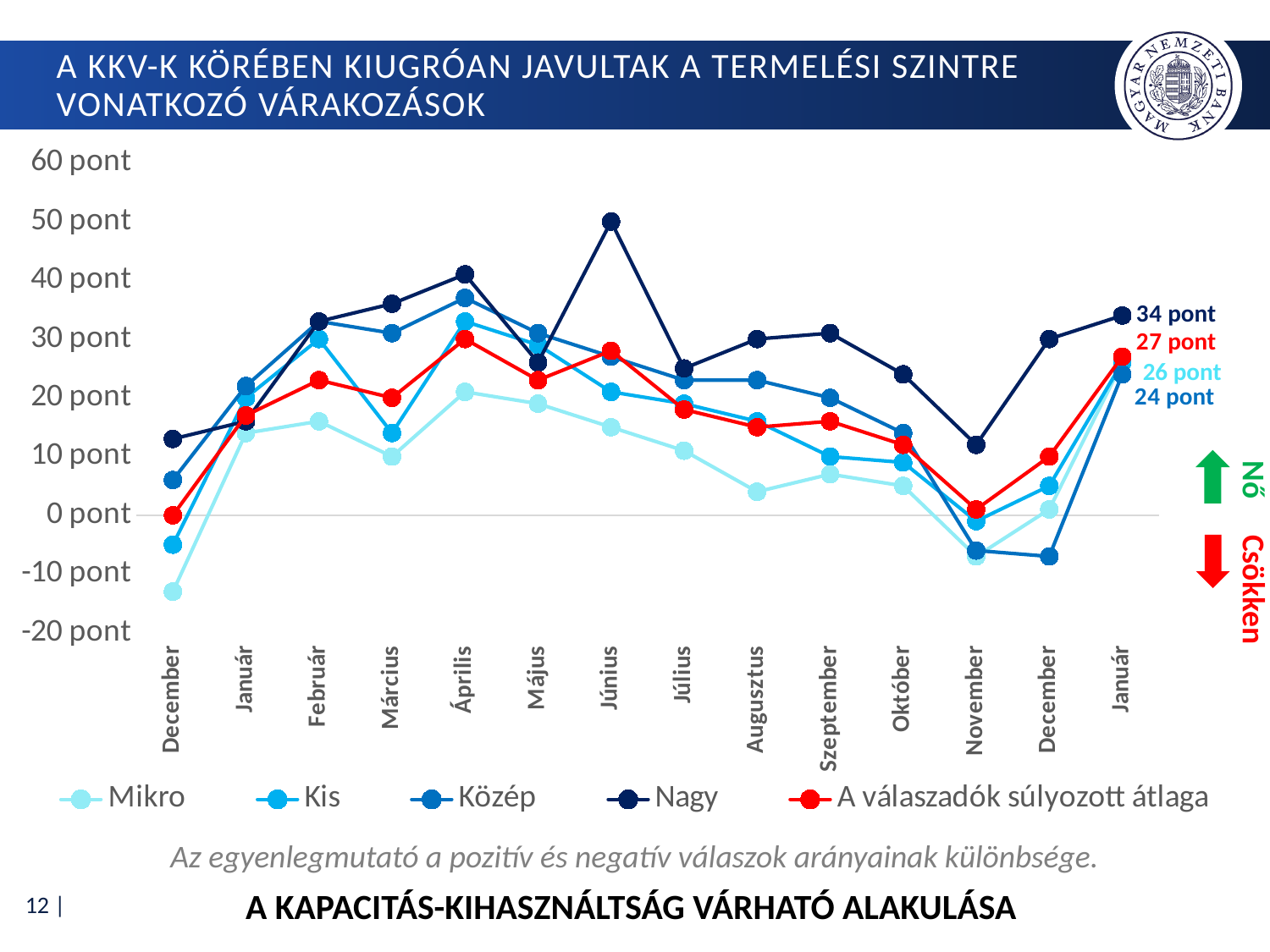
Is the value of the Nagy series in Június greater or less than 40 pont? greater At the final Január point, how much higher is the Nagy series than 'A válaszadók súlyozott átlaga'? 7 pont What is the value of the Nagy series at the final Január point? 34 pont How many series does the legend list? 5 What kind of chart is shown on the slide? line chart In Június, which series is larger: Nagy or Mikro? Nagy How many months are shown on the x axis? 14 What is the value of the Közép series at the final Január point? 24 pont What is the value of 'A válaszadók súlyozott átlaga' at the final Január point? 27 pont What is the value of the Kis series at the final Január point? 26 pont At which point on the x axis is the Mikro series at its lowest? December (the first point) In which month does the Nagy series reach its highest value? Június